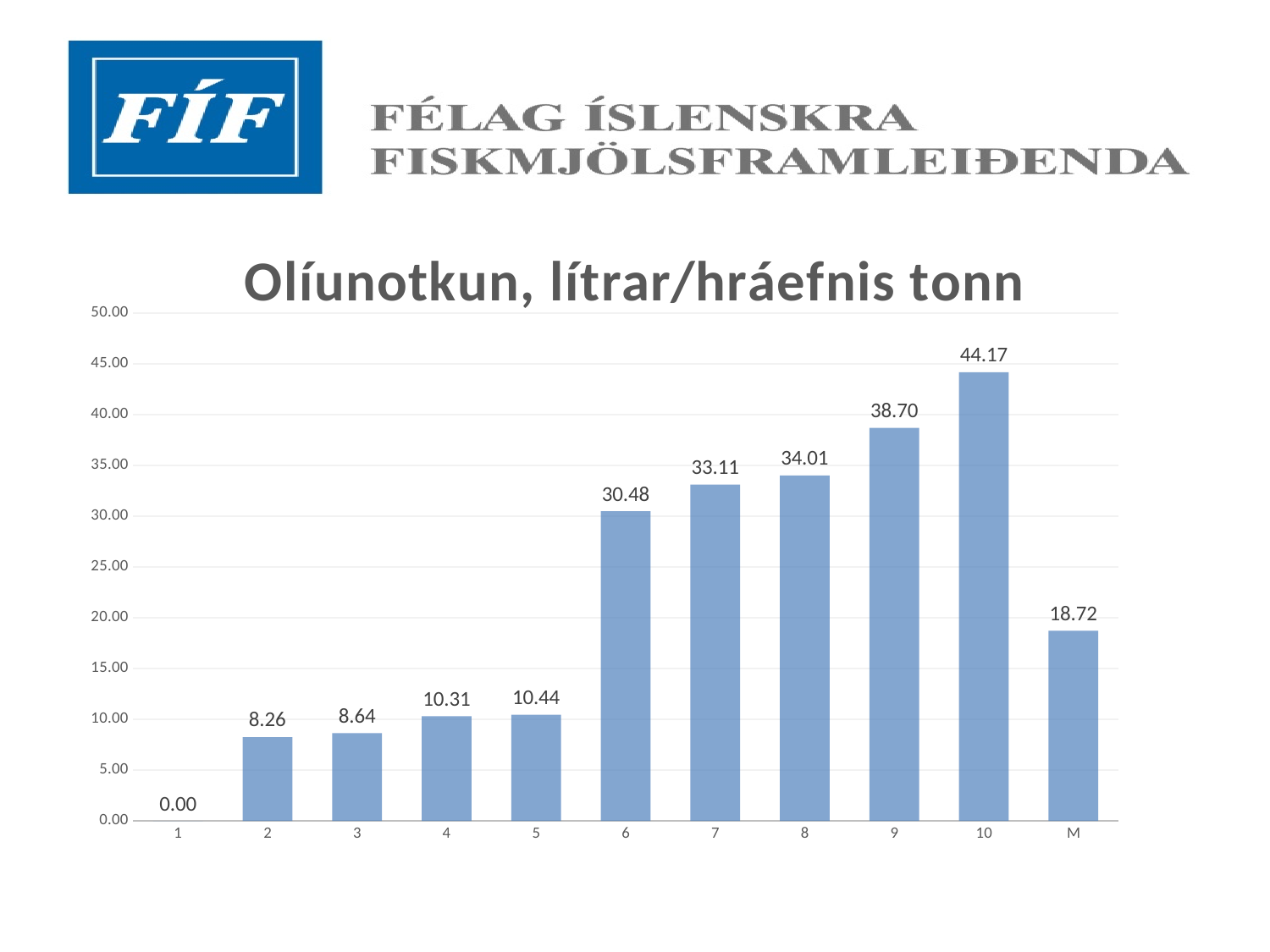
What is the value for category 2? 8.26 Which category has the lowest value? 1 Which category has the highest value? 10 What is the title of the chart? Olíunotkun, lítrar/hráefnis tonn Which is larger, the value for category 4 or category 5? 5 What is the difference between the values for category 10 and category 9? 5.47 How many categories are shown on the x axis? 11 Is the value for category 8 greater or less than 30.00? greater What is the value for category M? 18.72 Do the values rise or fall from category 1 to category 10? rise What is the value for category 6? 30.48 What kind of chart is shown? bar chart